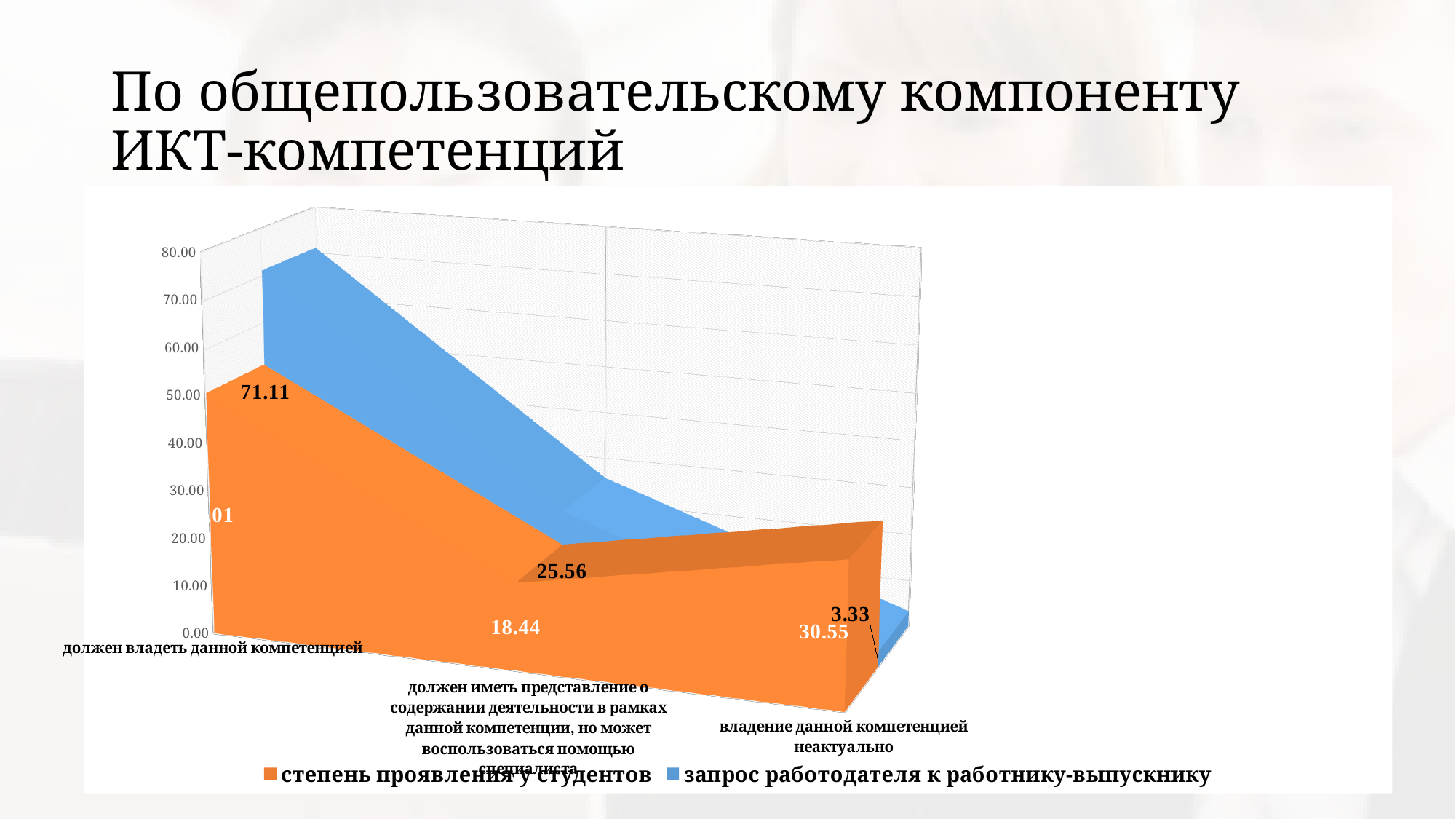
For which category is the value of "запрос работодателя к работнику-выпускнику" lowest? владение данной компетенцией неактуально What is the value of "степень проявления у студентов" for the category "должен иметь представление о содержании деятельности в рамках данной компетенции, но может воспользоваться помощью специалиста"? 18.44 What is the value of "степень проявления у студентов" for the category "владение данной компетенцией неактуально"? 30.55 What is the value of "запрос работодателя к работнику-выпускнику" for the category "владение данной компетенцией неактуально"? 3.33 Do the values of "запрос работодателя к работнику-выпускнику" rise or fall across the categories from left to right? fall For which category is the value of "запрос работодателя к работнику-выпускнику" highest? должен владеть данной компетенцией What kind of chart is shown on the slide? area chart For the category "владение данной компетенцией неактуально", which series has the larger value: "степень проявления у студентов" or "запрос работодателя к работнику-выпускнику"? степень проявления у студентов What is the difference between the "запрос работодателя к работнику-выпускнику" values for "должен владеть данной компетенцией" and "владение данной компетенцией неактуально"? 67.78 What is the value of "запрос работодателя к работнику-выпускнику" for the category "должен владеть данной компетенцией"? 71.11 For the category "должен иметь представление о содержании деятельности в рамках данной компетенции, но может воспользоваться помощью специалиста", which series has the larger value? запрос работодателя к работнику-выпускнику How many series does the legend list? 2